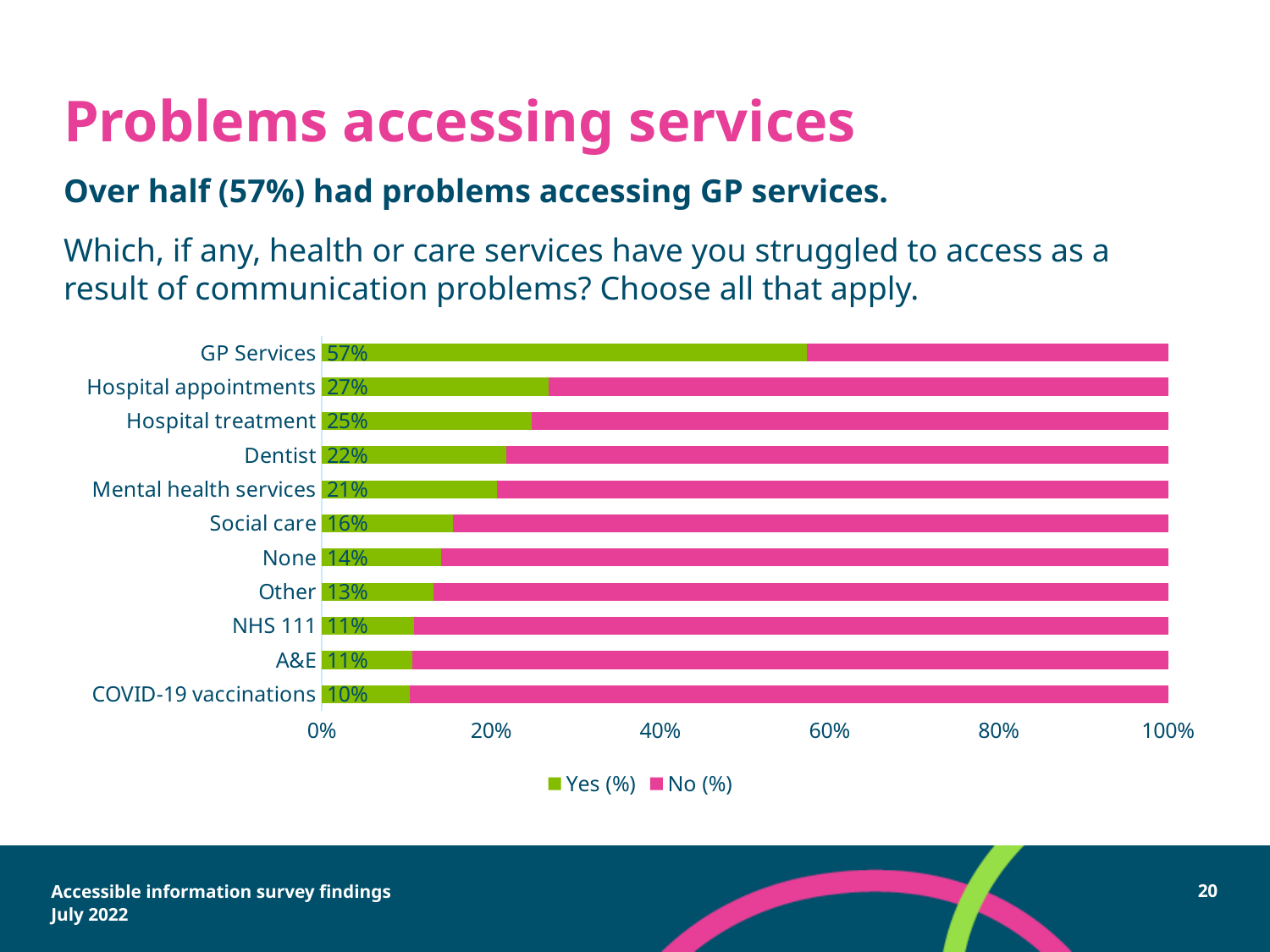
What is the difference between the Yes (%) values for GP Services and Hospital appointments? 30% Which category has the lowest Yes (%) value? COVID-19 vaccinations Which category has the highest Yes (%) value? GP Services What is the Yes (%) value for Social care? 16% What is the Yes (%) value for Dentist? 22% How many categories are shown on the chart? 11 What is the Yes (%) value for GP Services? 57% Which has a larger Yes (%) value, Hospital treatment or Mental health services? Hospital treatment What kind of chart is shown on the slide? Stacked bar chart Which series is shown in green in the legend? Yes (%) How many series does the legend list? 2 Is the No (%) value for GP Services greater or less than 60%? less